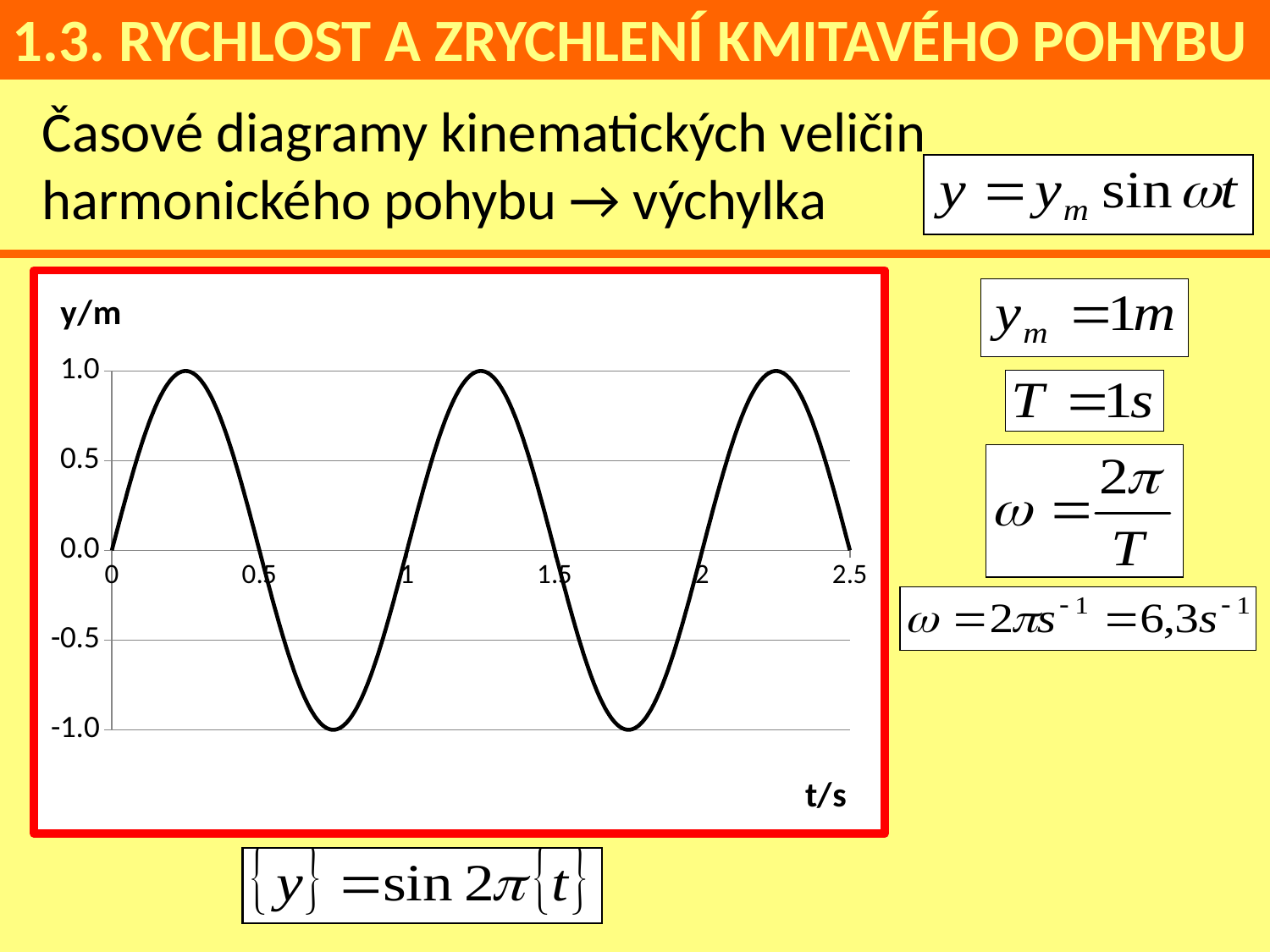
What is the highest value the curve reaches on the y/m axis? 1.0 Is the value of y/m at t/s = 0.75 greater or less than -0.5? less How many peaks (maxima) does the curve show between t/s = 0 and t/s = 2.5? 3 What is the value of y/m at t/s = 1? 0.0 What is the label of the vertical axis of the chart? y/m Is the value of y/m at t/s = 0.25 greater or less than 0.5? greater What is the value of y/m at t/s = 0? 0.0 What is the label of the horizontal axis of the chart? t/s What kind of chart is shown on the slide? line chart What is the lowest value the curve reaches on the y/m axis? -1.0 Does the curve rise or fall between t/s = 0 and t/s = 0.25? rise What is the value of y/m at t/s = 2.5? 0.0